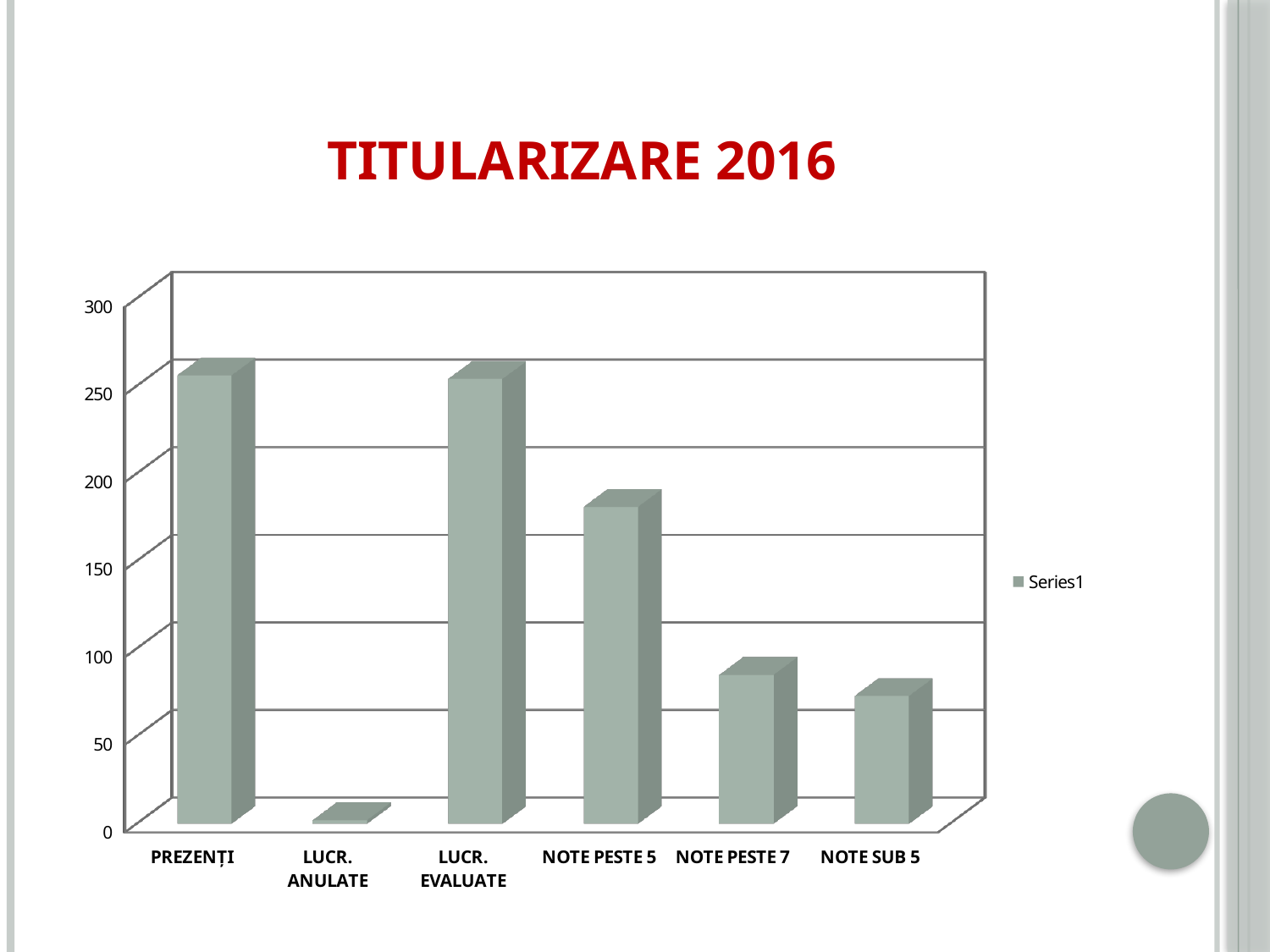
What is the title shown above the chart? TITULARIZARE 2016 Is the value for NOTE SUB 5 greater or less than 50? greater Is the value for NOTE PESTE 5 greater or less than 150? greater Is the value for PREZENȚI greater or less than 200? greater Which category has the lowest value in the chart? LUCR. ANULATE Which is larger, the value for NOTE PESTE 5 or the value for NOTE PESTE 7? NOTE PESTE 5 How many categories are shown on the x axis of the chart? 6 What kind of chart is shown on the slide? bar chart How many series does the chart's legend list? 1